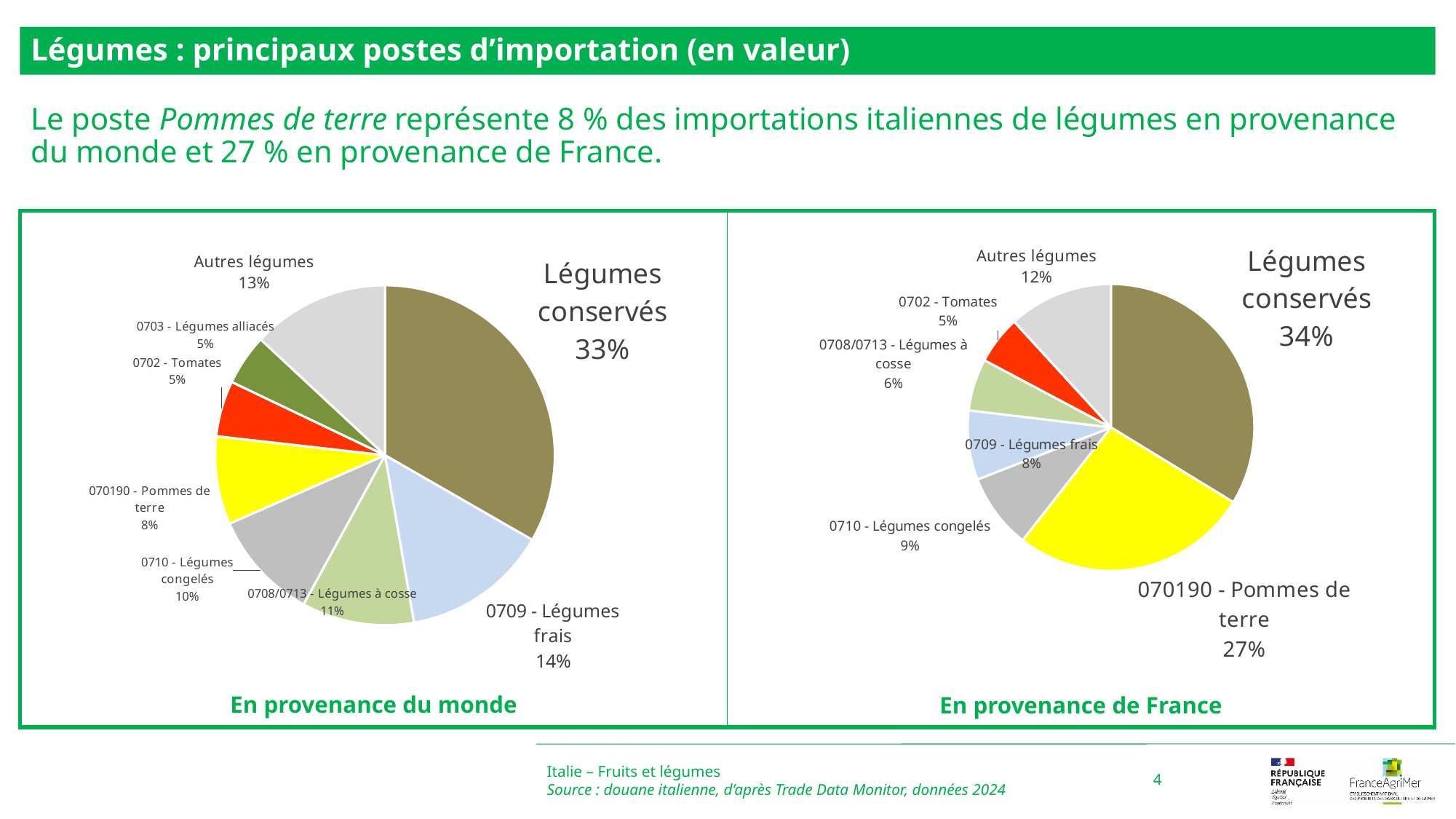
How many slices does the 'En provenance du monde' pie chart have? 8 In the 'En provenance de France' pie chart, what share is shown for 070190 - Pommes de terre? 27% In the 'En provenance de France' pie chart, what share is shown for 0710 - Légumes congelés? 9% In the 'En provenance du monde' pie chart, what share is shown for Autres légumes? 13% How many slices does the 'En provenance de France' pie chart have? 7 In the 'En provenance du monde' pie chart, which is larger: 0710 - Légumes congelés or 0708/0713 - Légumes à cosse? 0708/0713 - Légumes à cosse What type of chart is used on this slide? Pie chart In the 'En provenance du monde' pie chart, what share is shown for Légumes conservés? 33% In the 'En provenance du monde' pie chart, which category has the largest share? Légumes conservés In the 'En provenance de France' pie chart, which category has the smallest share? 0702 - Tomates In the 'En provenance de France' pie chart, what is the difference in percentage points between Légumes conservés and 070190 - Pommes de terre? 7 percentage points In the 'En provenance du monde' pie chart, what share is shown for 0709 - Légumes frais? 14%